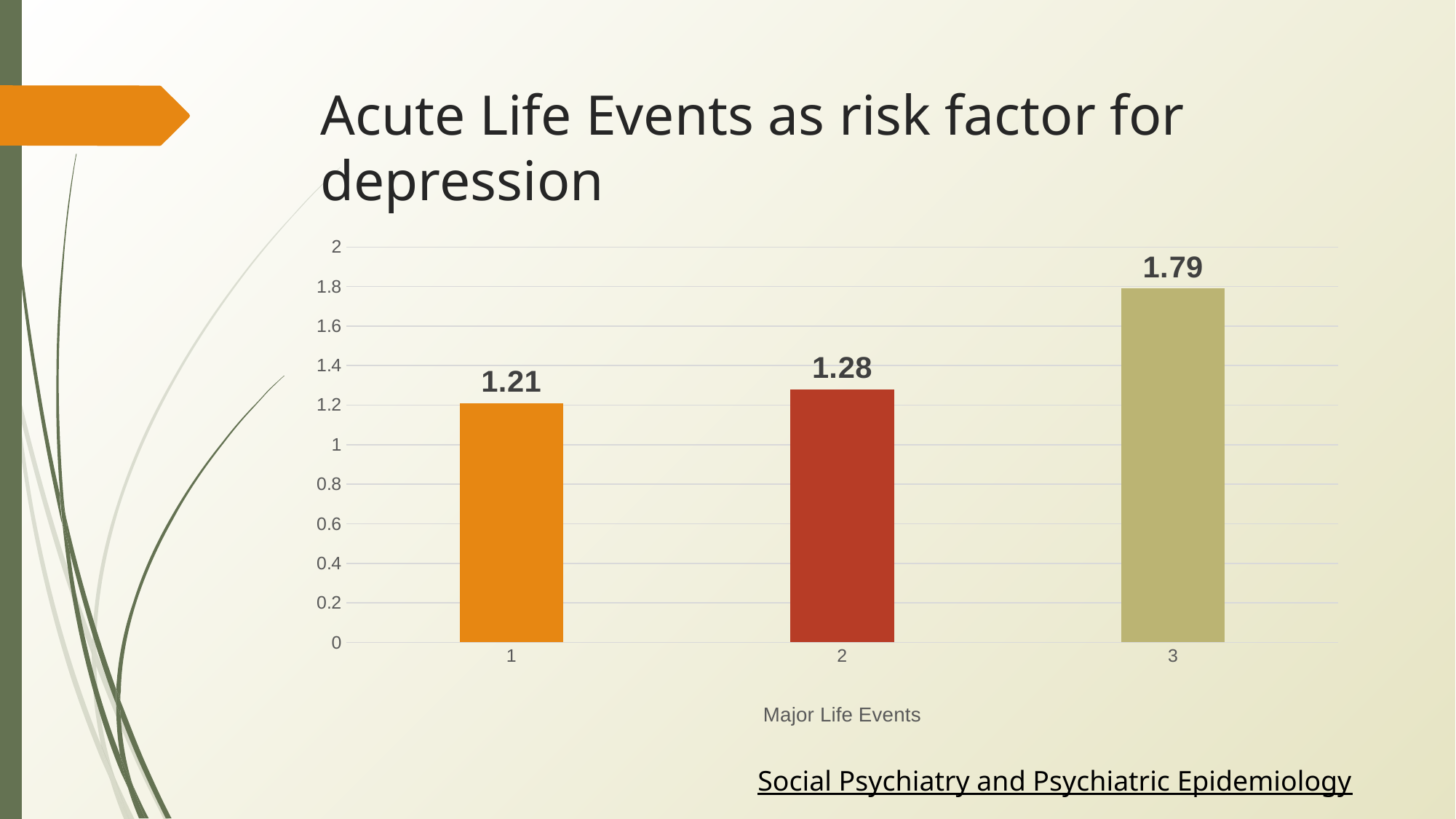
Which category has the highest value? 3 How many categories are shown on the x axis? 3 Do the values rise or fall from category 1 to category 3? rise Is the value for category 3 greater or less than 1.6? greater What is the value for category 2 (Major Life Events)? 1.28 What kind of chart is shown on the slide? bar chart Which category has the lowest value? 1 What is the difference between the values for category 2 and category 1? 0.07 What is the value for category 1 (Major Life Events)? 1.21 Which is larger, the value for category 3 or the value for category 2? category 3 What is the difference between the values for category 3 and category 1? 0.58 What is the value for category 3 (Major Life Events)? 1.79